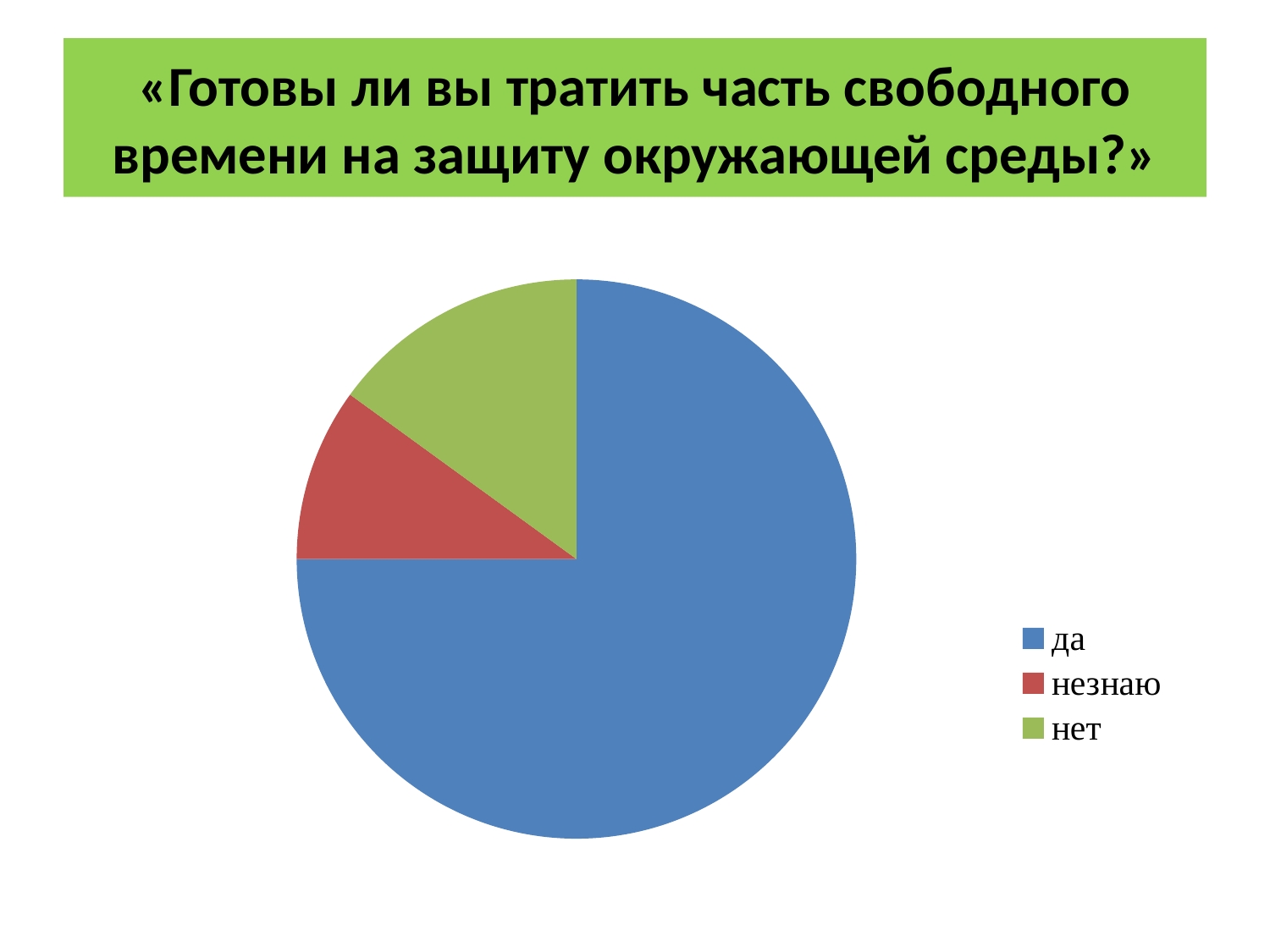
Which category is shown in green in the pie chart? нет Which slice is larger, "нет" or "незнаю"? нет How many slices does the pie chart have? 3 Which category has the smallest slice of the pie chart? незнаю Which category has the largest slice of the pie chart? да What kind of chart is shown on the slide? pie chart What colour is the "да" slice in the pie chart? blue Does the "да" slice take up more or less than half of the pie chart? more Which slice is larger, "да" or "нет"? да How many entries does the legend of the pie chart list? 3